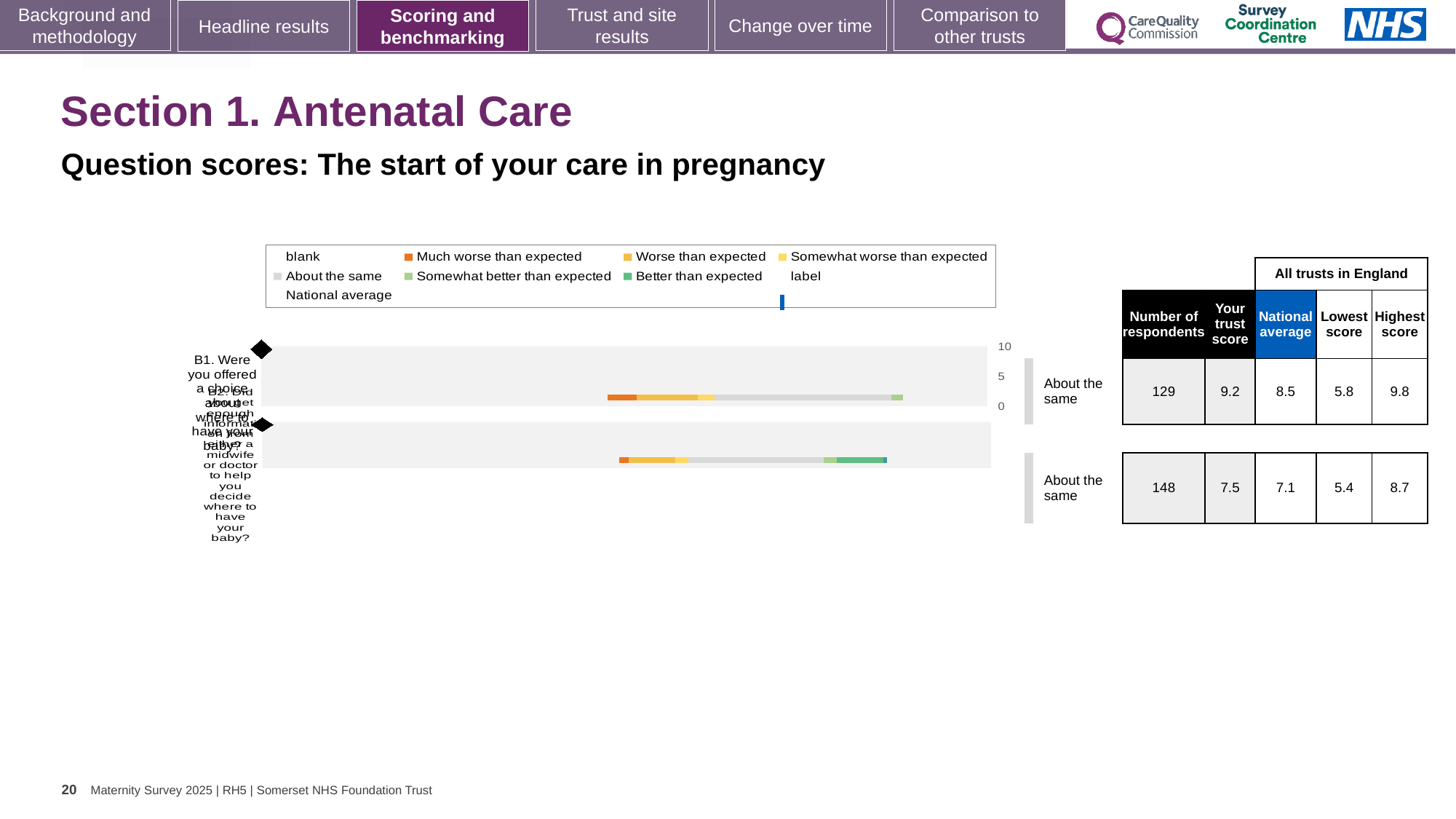
How many questions (bars) are plotted in the chart? 2 What benchmark category is shown for question B1? About the same What is the 'Your trust score' for question B1 (Were you offered a choice about where to have your baby?)? 9.2 How many respondents answered question B1? 129 What is the lowest score among all trusts in England for question B2? 5.4 What is the national average score for question B2 (Did you get enough information from either a midwife or doctor to help you decide where to have your baby?)? 7.1 What is the difference between the trust score and the national average for question B1? 0.7 Which colour in the legend represents 'Much worse than expected'? orange Which question had more respondents, B1 or B2? B2 What is the highest score among all trusts in England for question B1? 9.8 What kind of chart is used to show the question scores on this slide? bar chart Which is larger for question B2: the trust score or the national average? the trust score (7.5)